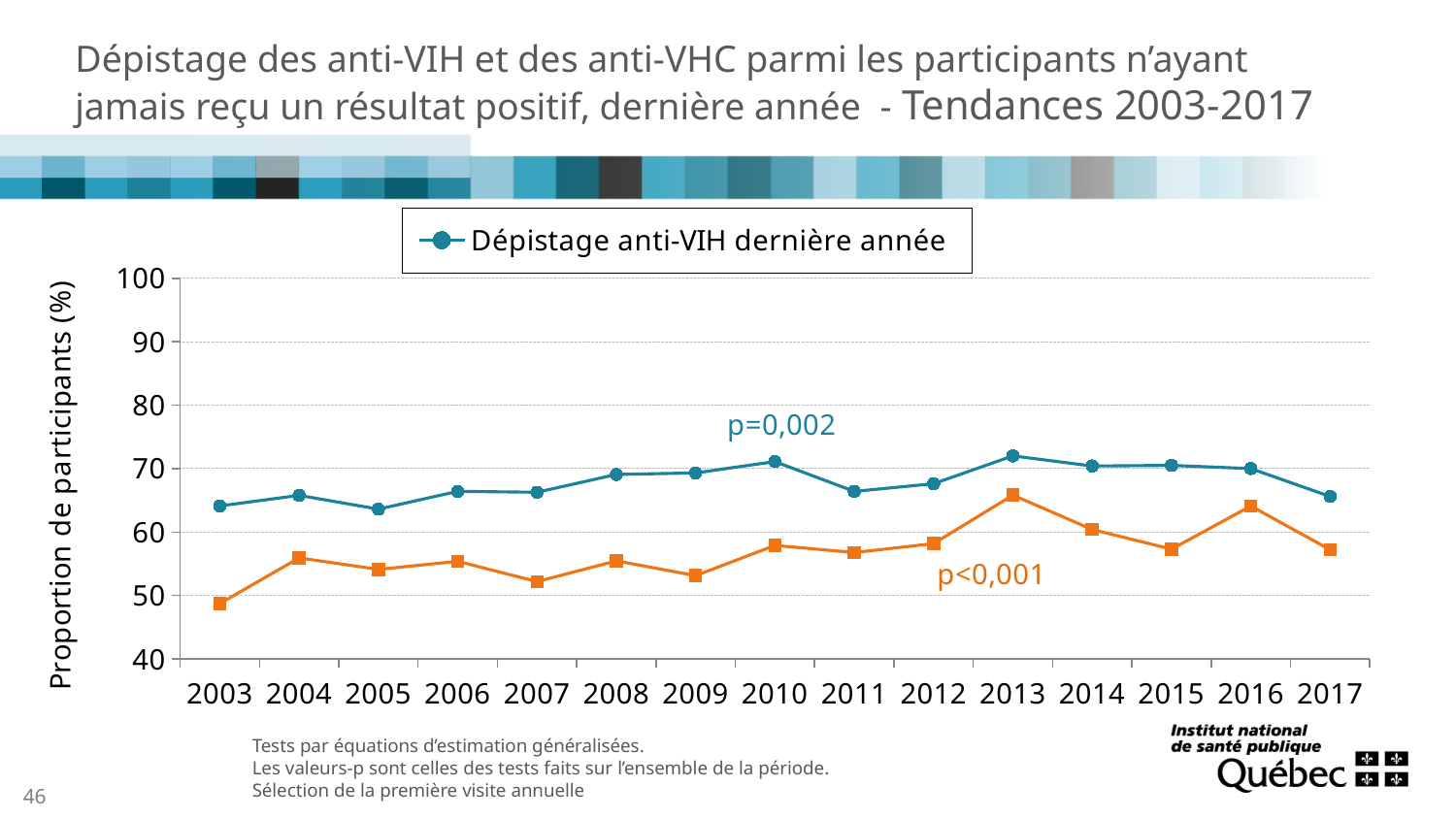
Is the value for the orange (square-marker) series in 2013 greater or less than 60? greater What p-value is annotated next to the Dépistage anti-VIH dernière année line? p=0,002 Is the value for the orange (square-marker) series in 2003 greater or less than 50? less Does the Dépistage anti-VIH dernière année line rise or fall from 2016 to 2017? fall Is the value for Dépistage anti-VIH dernière année in 2003 greater or less than 60? greater Which year has the lowest value for the orange (square-marker) series? 2003 In 2003, which series has the larger value: Dépistage anti-VIH dernière année or the orange (square-marker) series? Dépistage anti-VIH dernière année How many series does the legend list? 1 What kind of chart is shown on the slide? line chart How many years are plotted along the x axis? 15 Which year has the highest value for the orange (square-marker) series? 2013